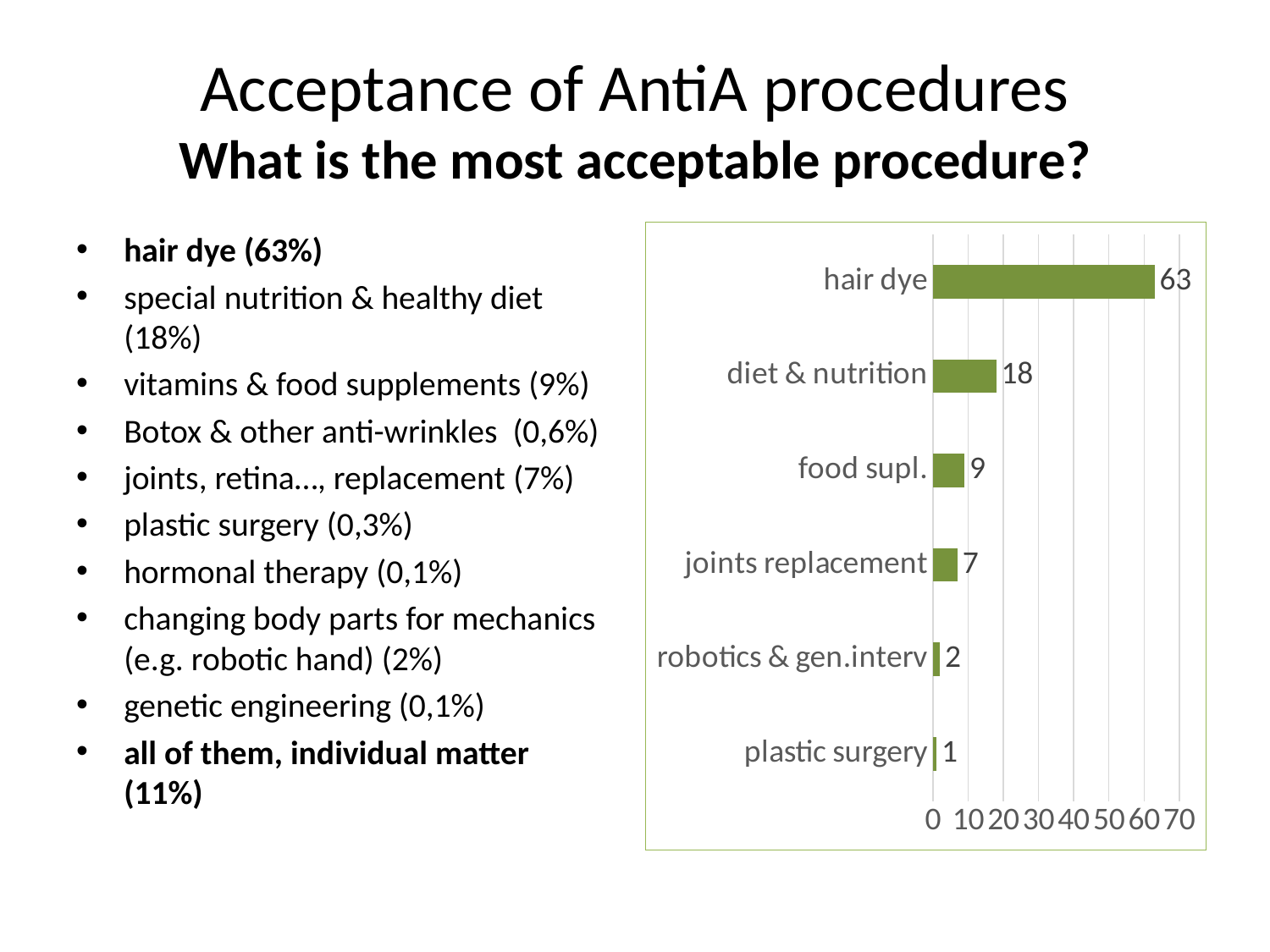
What is the value for diet & nutrition in the chart? 18 What is the highest tick value shown on the chart's value axis? 70 How many categories are shown in the chart? 6 Is the value for hair dye greater or less than 60? greater Which is larger, the value for food supl. or the value for joints replacement? food supl. What is the value for joints replacement in the chart? 7 What is the difference between the values for hair dye and diet & nutrition? 45 What is the value for hair dye in the chart? 63 What is the value for plastic surgery in the chart? 1 Which category has the highest value in the chart? hair dye Which category has the lowest value in the chart? plastic surgery What kind of chart is shown on the slide? bar chart